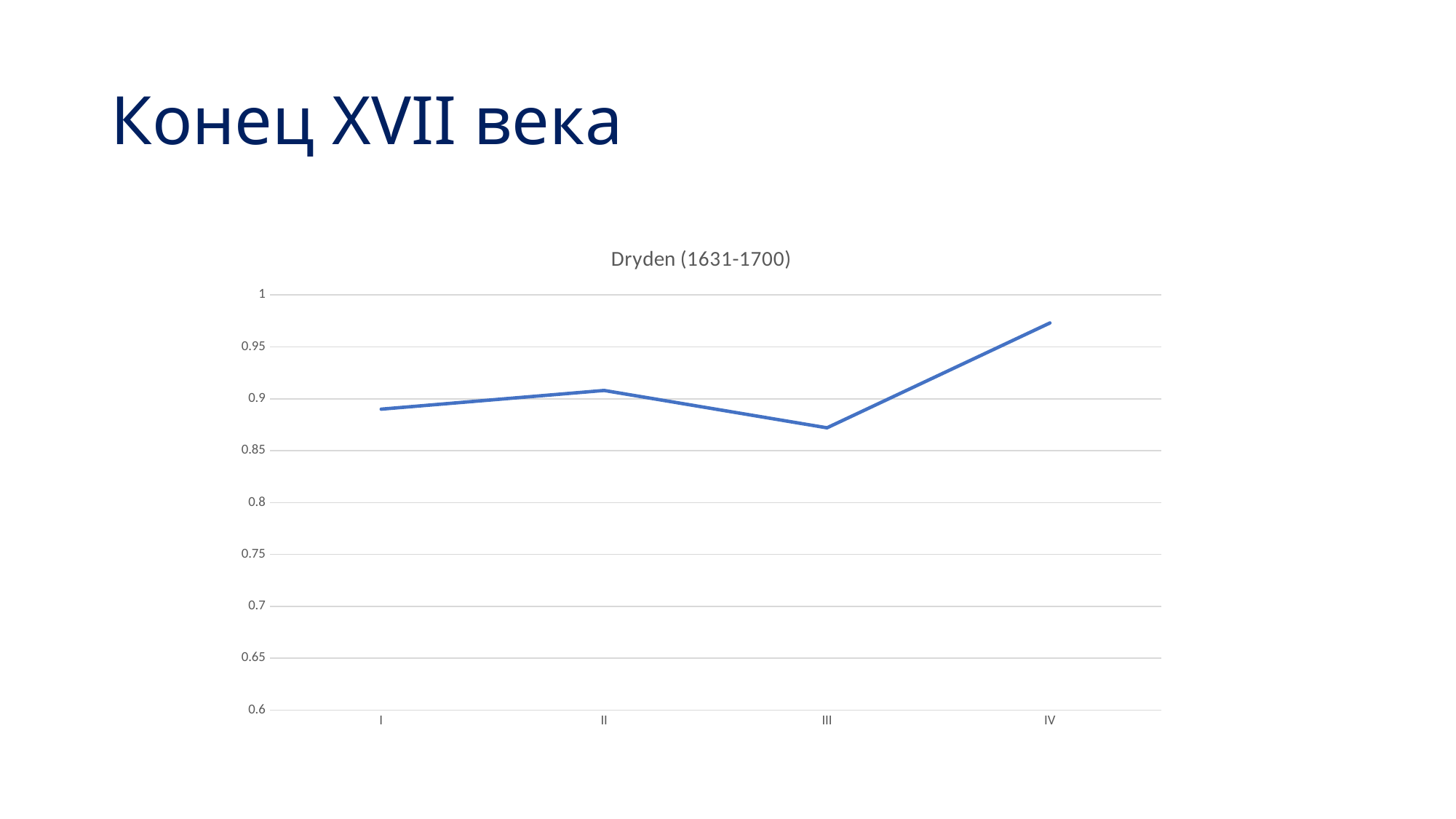
What kind of chart is shown on the slide? line chart Which category has the lowest value? III Is the value for III greater or less than 0.9? less Does the line rise or fall from III to IV? rise Is the value for IV greater or less than 1? less Is the value for I greater or less than 0.85? greater What is the title of the chart? Dryden (1631-1700) How many points are plotted along the x axis? 4 Which is larger, the value for IV or the value for I? IV Which is larger, the value for II or the value for III? II Which category has the highest value? IV